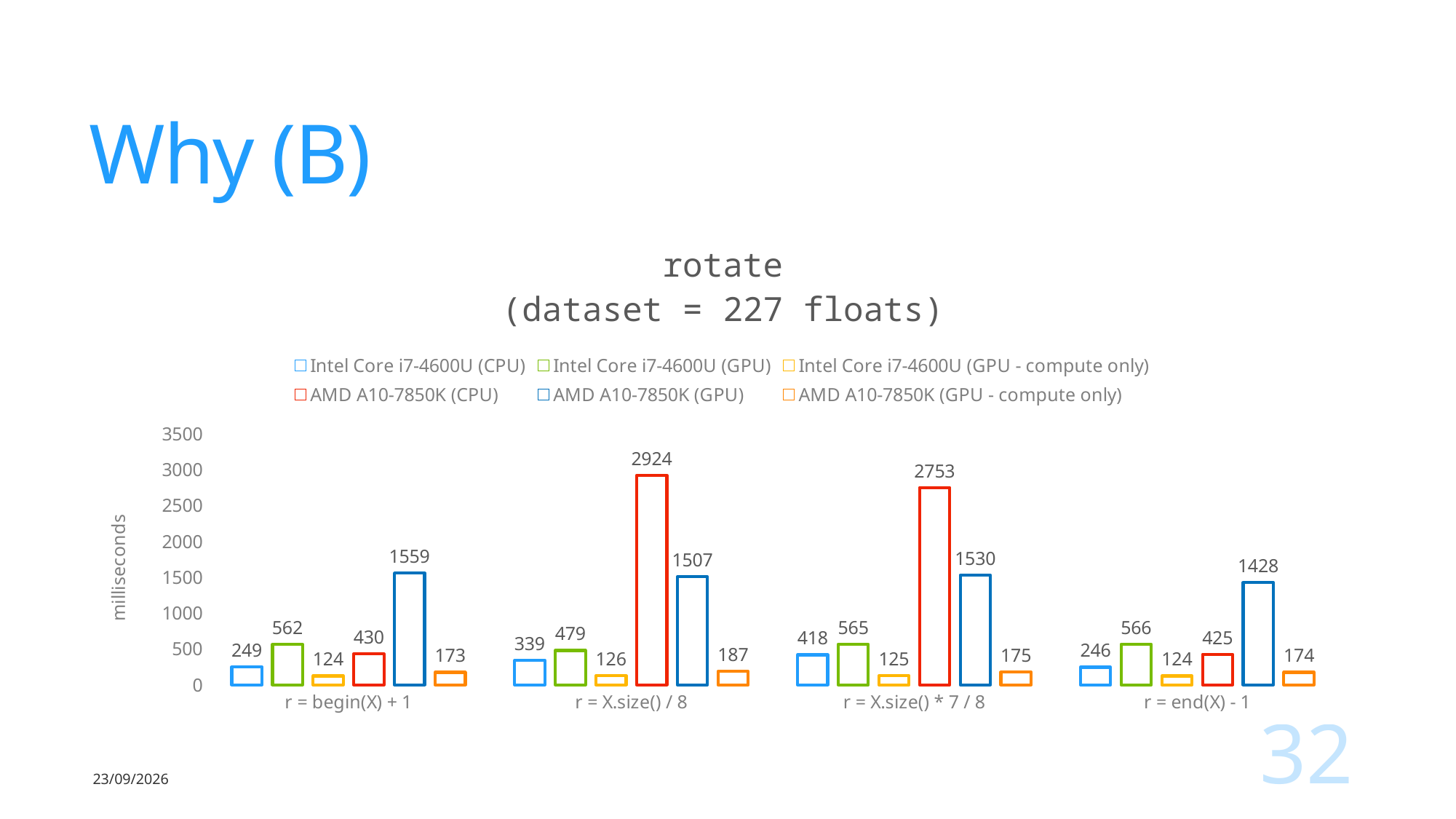
What is the value for Intel Core i7-4600U (GPU) at r = end(X) - 1? 566 What kind of chart is shown on the slide? Bar chart What is the value for AMD A10-7850K (CPU) at r = X.size() / 8? 2924 What is the value for Intel Core i7-4600U (GPU - compute only) at r = X.size() * 7 / 8? 125 Which category has the highest value for AMD A10-7850K (CPU)? r = X.size() / 8 What is the label of the vertical axis? milliseconds Which category has the lowest value for Intel Core i7-4600U (CPU)? r = end(X) - 1 Which is larger at r = begin(X) + 1: Intel Core i7-4600U (GPU) or AMD A10-7850K (CPU)? Intel Core i7-4600U (GPU) How many categories are shown on the x axis? 4 What is the value for AMD A10-7850K (GPU) at r = begin(X) + 1? 1559 What is the difference between the AMD A10-7850K (CPU) values at r = X.size() / 8 and r = X.size() * 7 / 8? 171 How many series does the legend list? 6